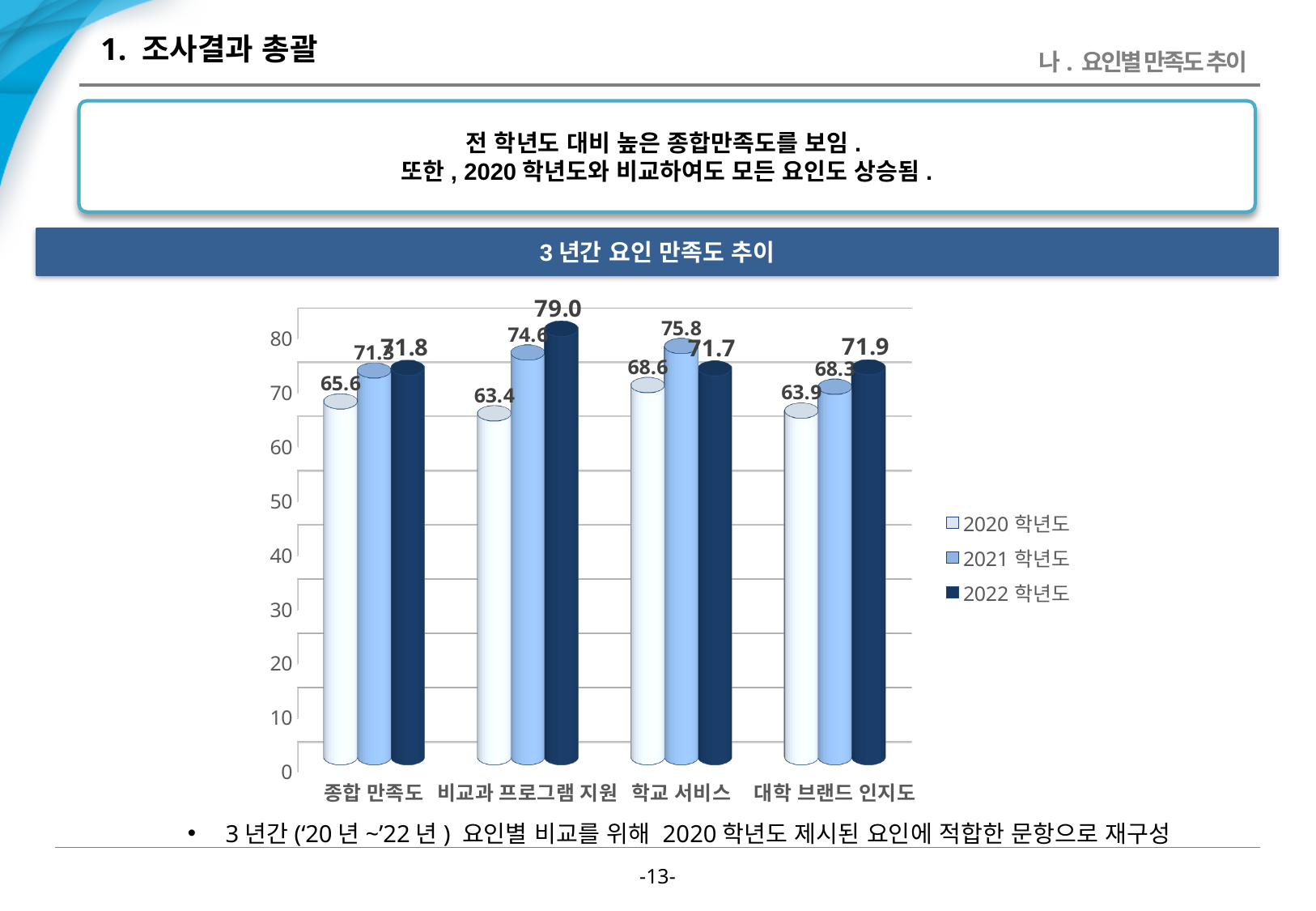
What is the value for 학교 서비스 in 2021 학년도? 75.8 What is the value for 대학 브랜드 인지도 in 2020 학년도? 63.9 Which category has the lowest value in 2020 학년도? 비교과 프로그램 지원 How many series does the legend list? 3 For 학교 서비스, which is larger: the 2021 학년도 value or the 2022 학년도 value? 2021 학년도 What is the difference between the 2022 학년도 and 2020 학년도 values for 비교과 프로그램 지원? 15.6 Which category has the highest value in 2022 학년도? 비교과 프로그램 지원 What is the title of the chart? 3 년간 요인 만족도 추이 How many categories are shown on the x axis? 4 What is the value for 비교과 프로그램 지원 in 2022 학년도? 79.0 What is the value for 종합 만족도 in 2020 학년도? 65.6 What type of chart is shown on the slide? bar chart